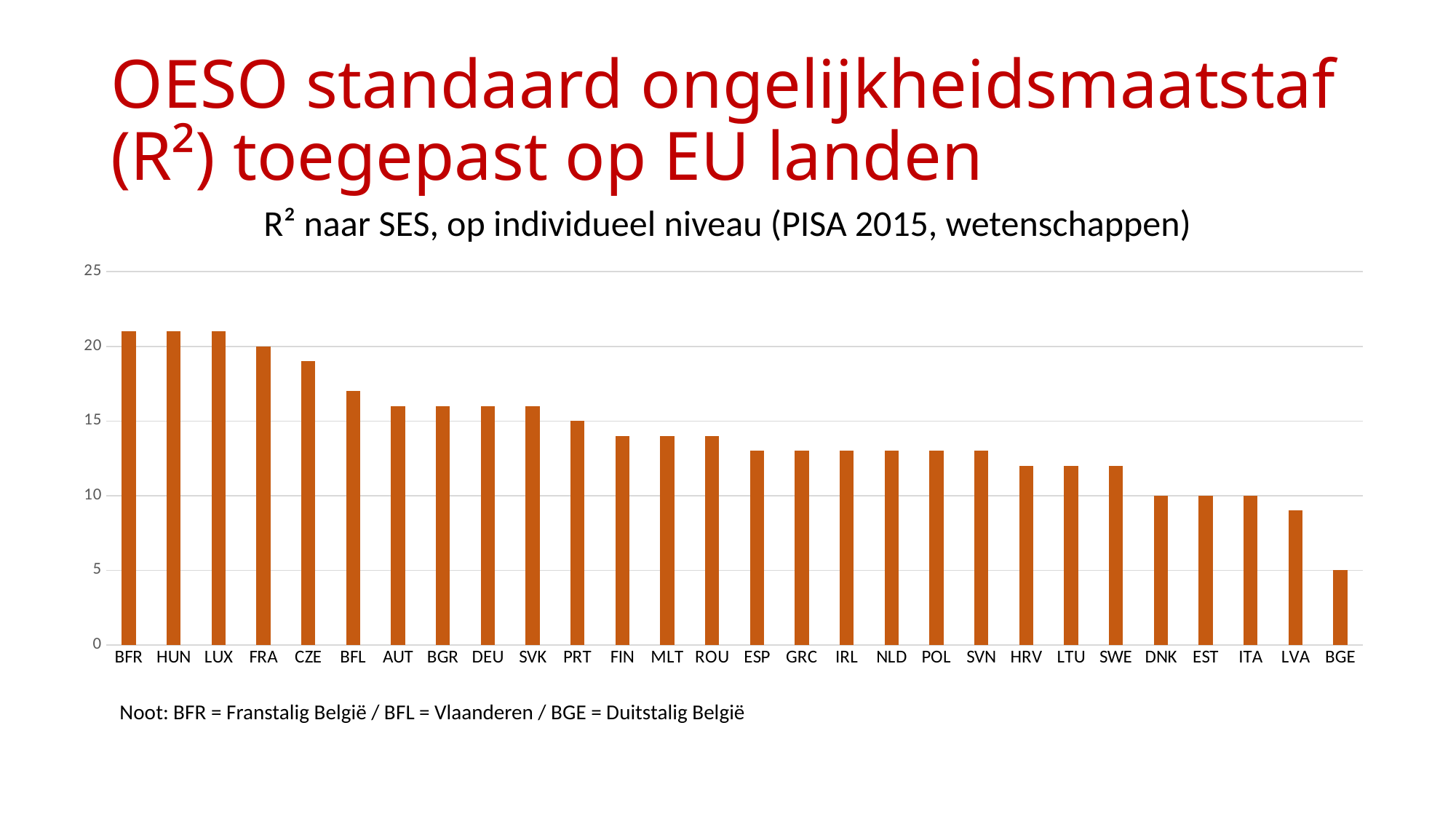
How many countries or regions are shown on the x axis of the chart? 28 What is the title of the chart? R² naar SES, op individueel niveau (PISA 2015, wetenschappen) Is the value for LVA greater or less than 10? less Is the value for CZE greater or less than 15? greater What is the value for FRA? 20 What is the value for BGE? 5 What kind of chart is shown on the slide? bar chart Which has the larger value, CZE or BFL? CZE Do the values rise or fall from left to right along the x axis? fall What is the value for PRT? 15 Which category has the lowest value in the chart? BGE What is the difference between the values for FRA and PRT? 5